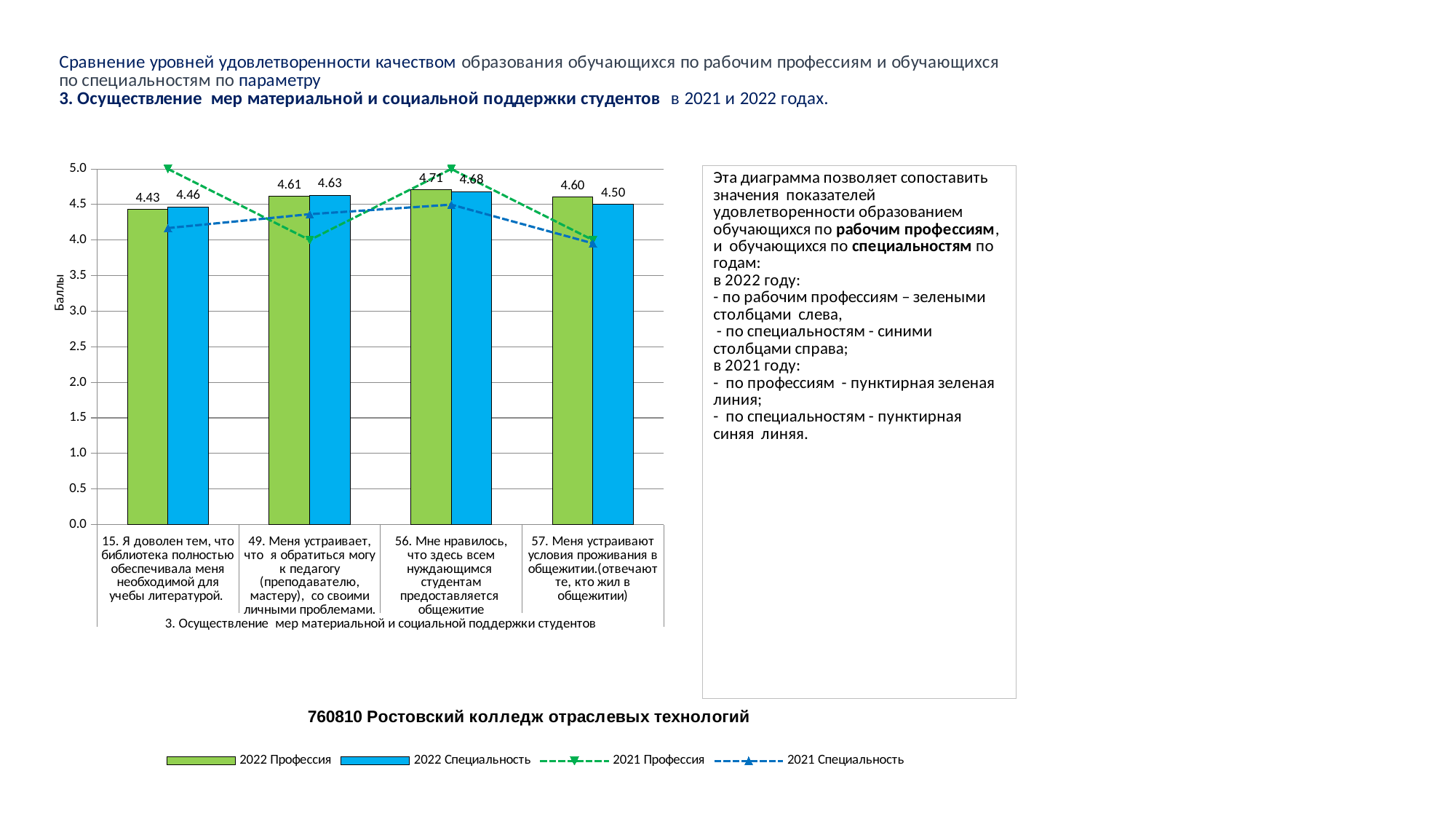
What is the value of the 2022 Профессия bar for item 15 (Я доволен тем, что библиотека полностью обеспечивала меня необходимой для учебы литературой)? 4.43 What is the label of the vertical axis? Баллы How many series does the legend list? 4 What is the value of the 2022 Профессия bar for item 49 (Меня устраивает, что я обратиться могу к педагогу)? 4.61 Which item has the highest 2022 Профессия bar? 56. Мне нравилось, что здесь всем нуждающимся студентам предоставляется общежитие Which item has the lowest 2022 Специальность bar? 15. Я доволен тем, что библиотека полностью обеспечивала меня необходимой для учебы литературой What is the difference between the 2022 Профессия and 2022 Специальность values for item 57? 0.10 How many survey items (categories) are shown on the x axis? 4 For item 49, which is larger: the 2022 Профессия value or the 2022 Специальность value? 2022 Специальность Is the 2021 Специальность value for item 15 greater or less than 4.5? less Is the 2021 Профессия value for item 15 greater or less than 4.5? greater What is the value of the 2022 Специальность bar for item 57 (Меня устраивают условия проживания в общежитии)? 4.50